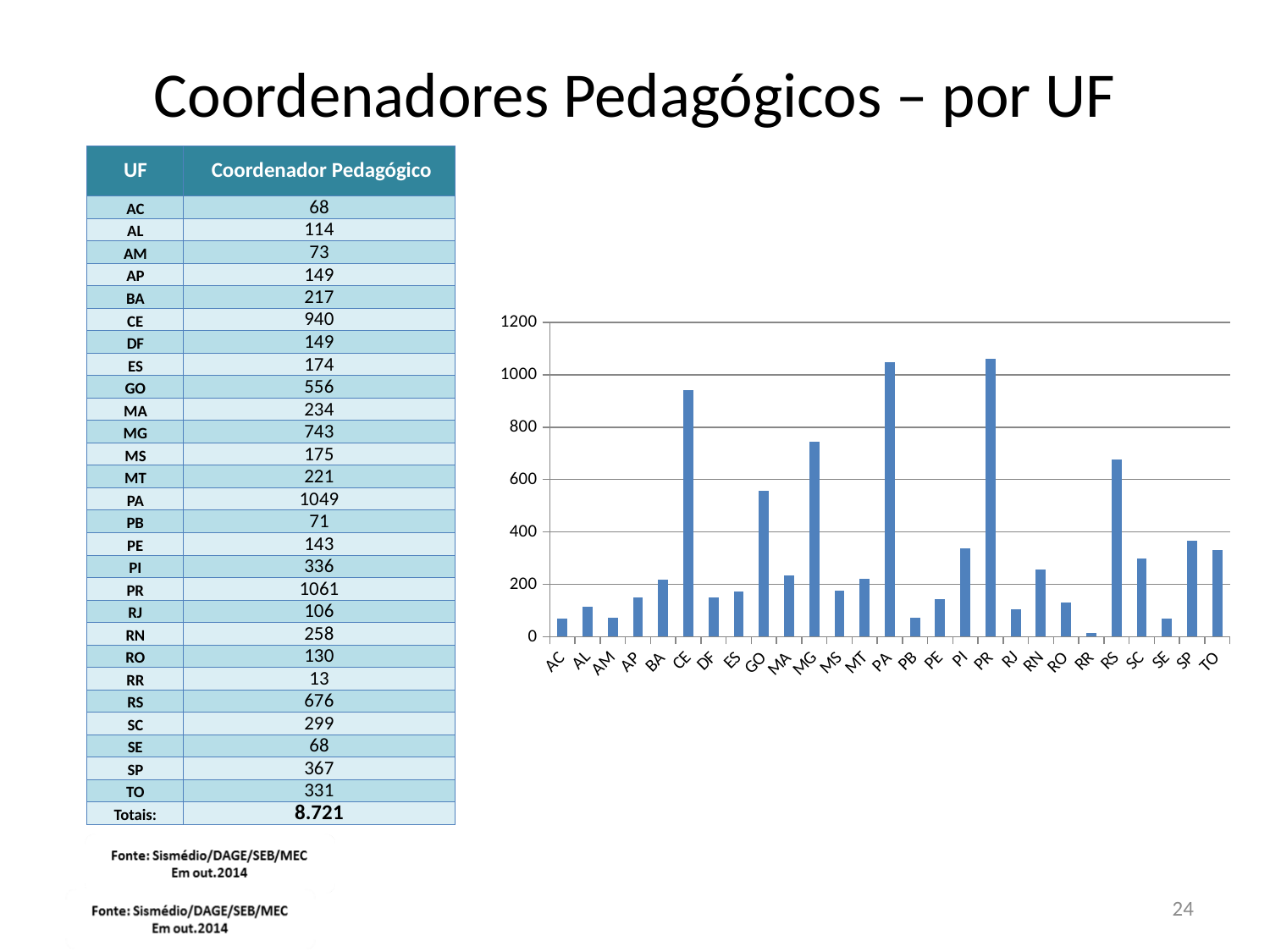
Which has more Coordenadores Pedagógicos, GO or RS? RS What is the total (Totais) of Coordenadores Pedagógicos shown in the table? 8.721 Is the bar for MG greater or less than 600 in the chart? greater According to the table, how many Coordenadores Pedagógicos does PA have? 1049 According to the table, how many Coordenadores Pedagógicos does CE have? 940 How many UF categories are plotted along the x axis of the chart? 27 What is the difference between the values for PR and PA in the table? 12 Which UF has the lowest number of Coordenadores Pedagógicos? RR Which UF has the highest number of Coordenadores Pedagógicos? PR According to the table, how many Coordenadores Pedagógicos does RR have? 13 What kind of chart is shown on the slide? bar chart Is the bar for SC greater or less than 400 in the chart? less